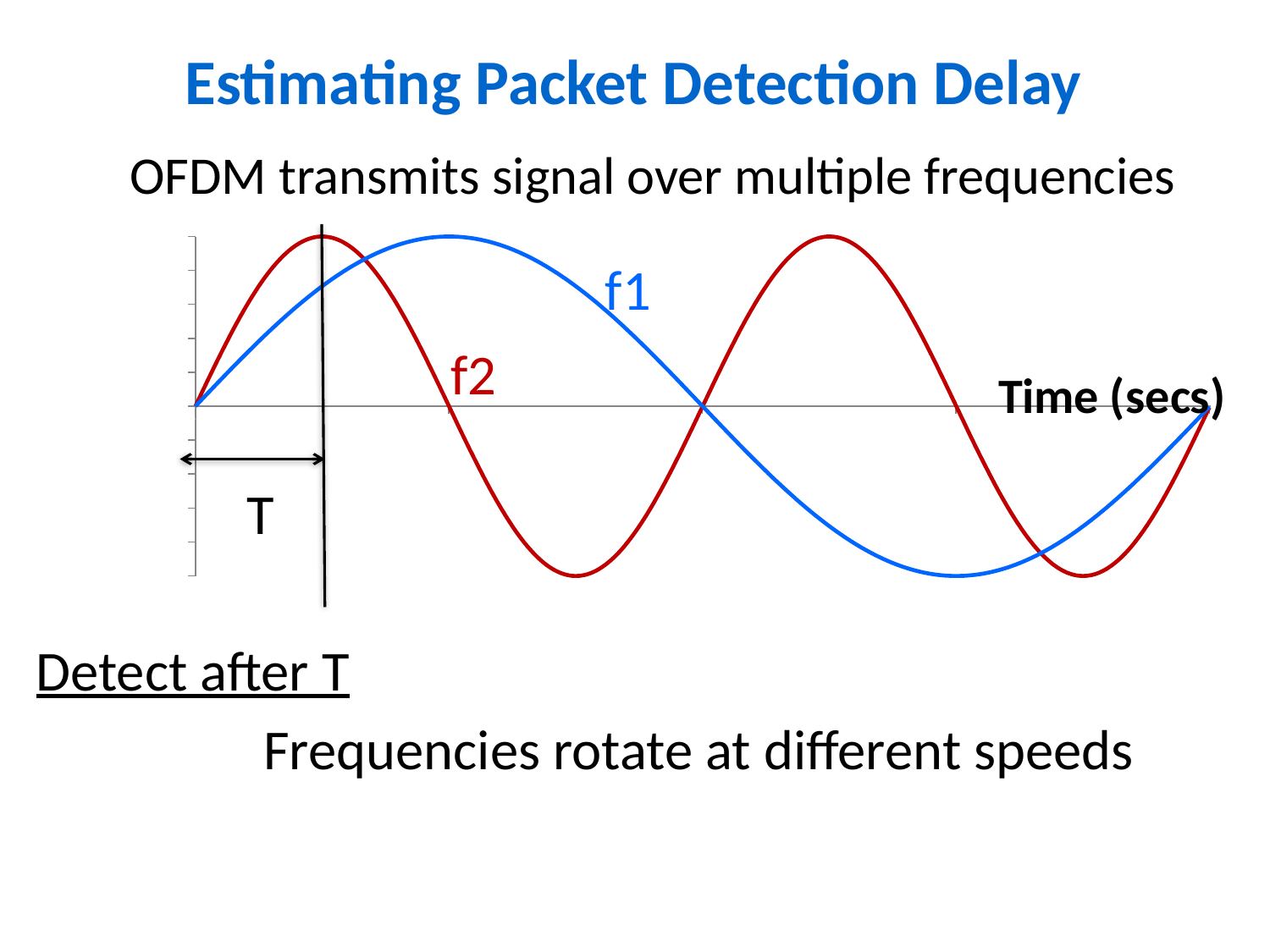
What are the labels of the two curves plotted on the chart? f1 and f2 Does the f2 curve rise or fall immediately after time zero? rise How many full cycles does the f2 curve complete over the plotted time range? 2 Which curve, f1 or f2, completes more full cycles over the plotted time range? f2 What is the label of the horizontal axis of the chart? Time (secs) How many full cycles does the f1 curve complete over the plotted time range? 1 Does the f1 curve rise or fall between its first peak and its trough? fall Which curve, f1 or f2, has the longer period? f1 How many signal curves are plotted on the chart? 2 What kind of chart is shown on the slide? line chart Which curve, f1 or f2, reaches its first peak earlier in time? f2 What does the horizontal double-headed arrow at the left of the chart mark? T